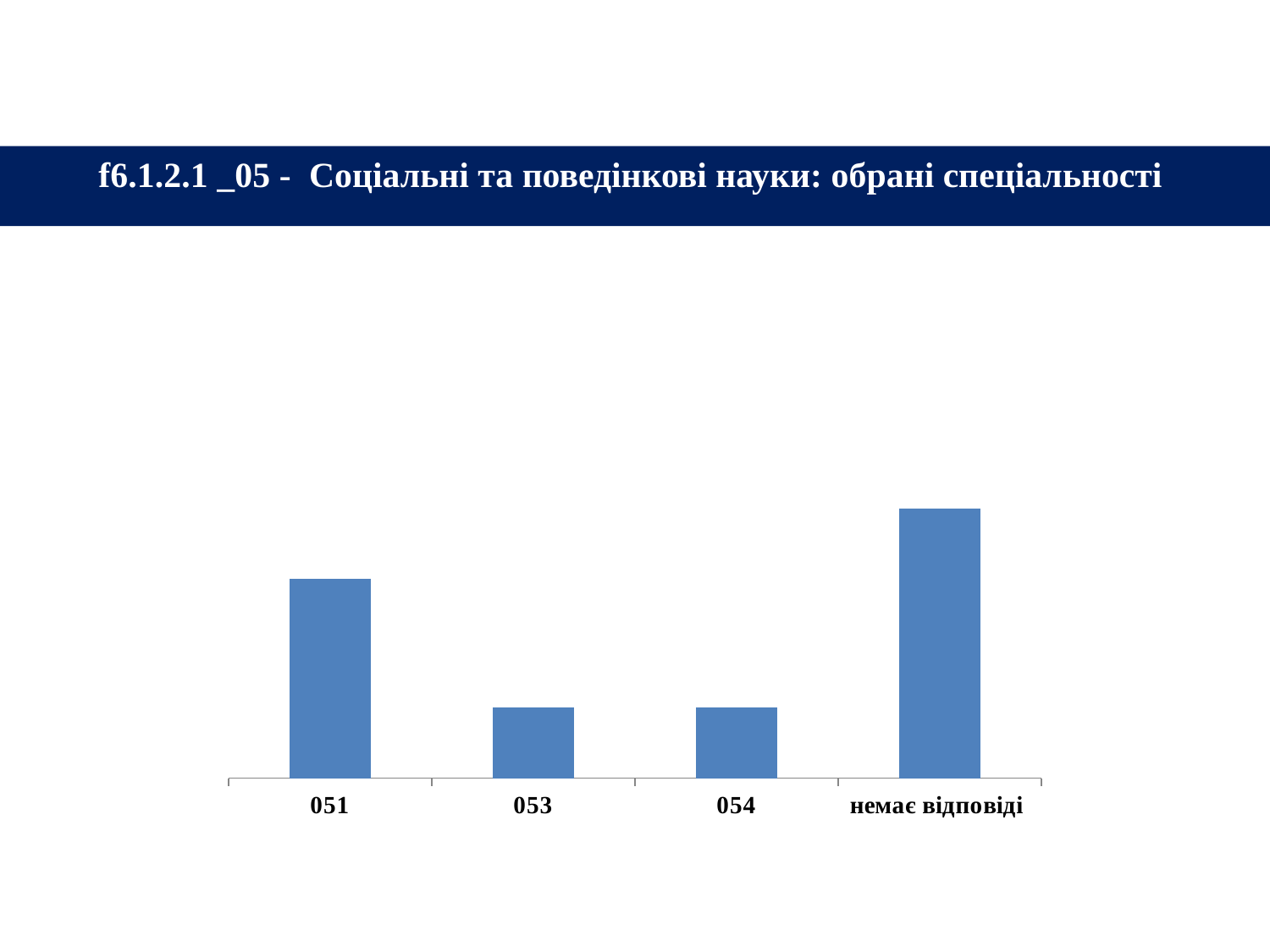
What is the title of the slide containing the chart? f6.1.2.1 _05 - Соціальні та поведінкові науки: обрані спеціальності Which is larger, the value for 051 or the value for 053? 051 How many categories are shown on the x axis of the chart? 4 Which category has the highest bar in the chart? немає відповіді What kind of chart is shown on the slide? bar chart Which is larger, the value for немає відповіді or the value for 051? немає відповіді Which is larger, the value for 051 or the value for 054? 051 What is the label of the last category on the x axis? немає відповіді